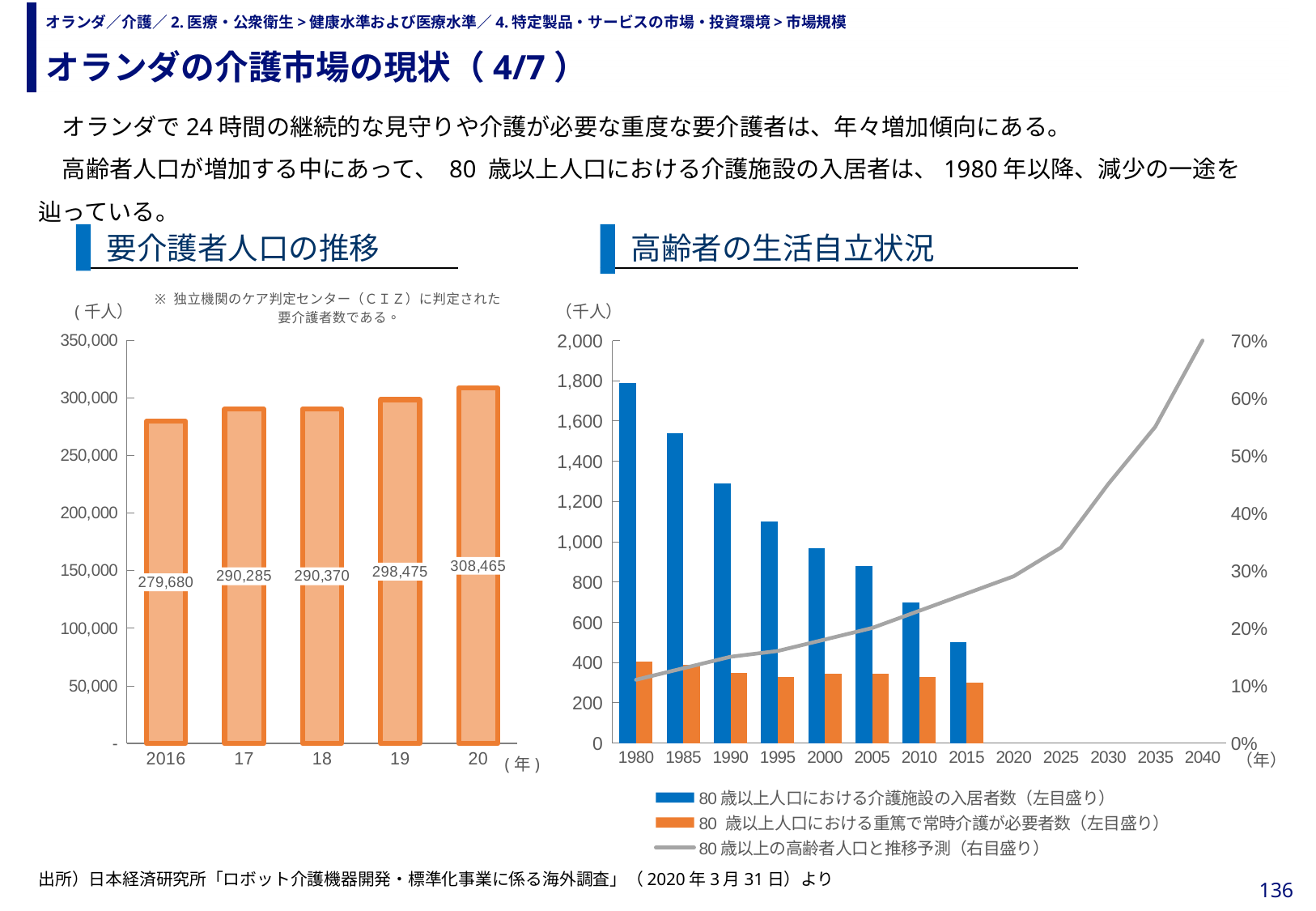
In the chart titled 高齢者の生活自立状況, do the values of 80歳以上人口における介護施設の入居者数 rise or fall from 1980 to 2015? fall In the chart titled 高齢者の生活自立状況, which series is drawn as a gray line? 80歳以上の高齢者人口と推移予測（右目盛り） In the chart titled 要介護者人口の推移, which year has the highest value? 20 In the chart titled 要介護者人口の推移, do the values rise or fall from 2016 to 20? rise In the chart titled 要介護者人口の推移, what is the value for 2016? 279,680 In the chart titled 高齢者の生活自立状況, how many series does the legend list? 3 In the chart titled 要介護者人口の推移, what is the value for 20 (2020)? 308,465 In the chart titled 高齢者の生活自立状況, is the value of 80歳以上人口における介護施設の入居者数 for 1980 greater or less than 1,600? greater In the chart titled 要介護者人口の推移, which year has the lowest value? 2016 In the chart titled 高齢者の生活自立状況, is the value of 80歳以上人口における介護施設の入居者数 for 2015 greater or less than 600? less In the chart titled 要介護者人口の推移, what is the difference between the values for 20 and 2016? 28,785 In the chart titled 要介護者人口の推移, how many years are plotted? 5